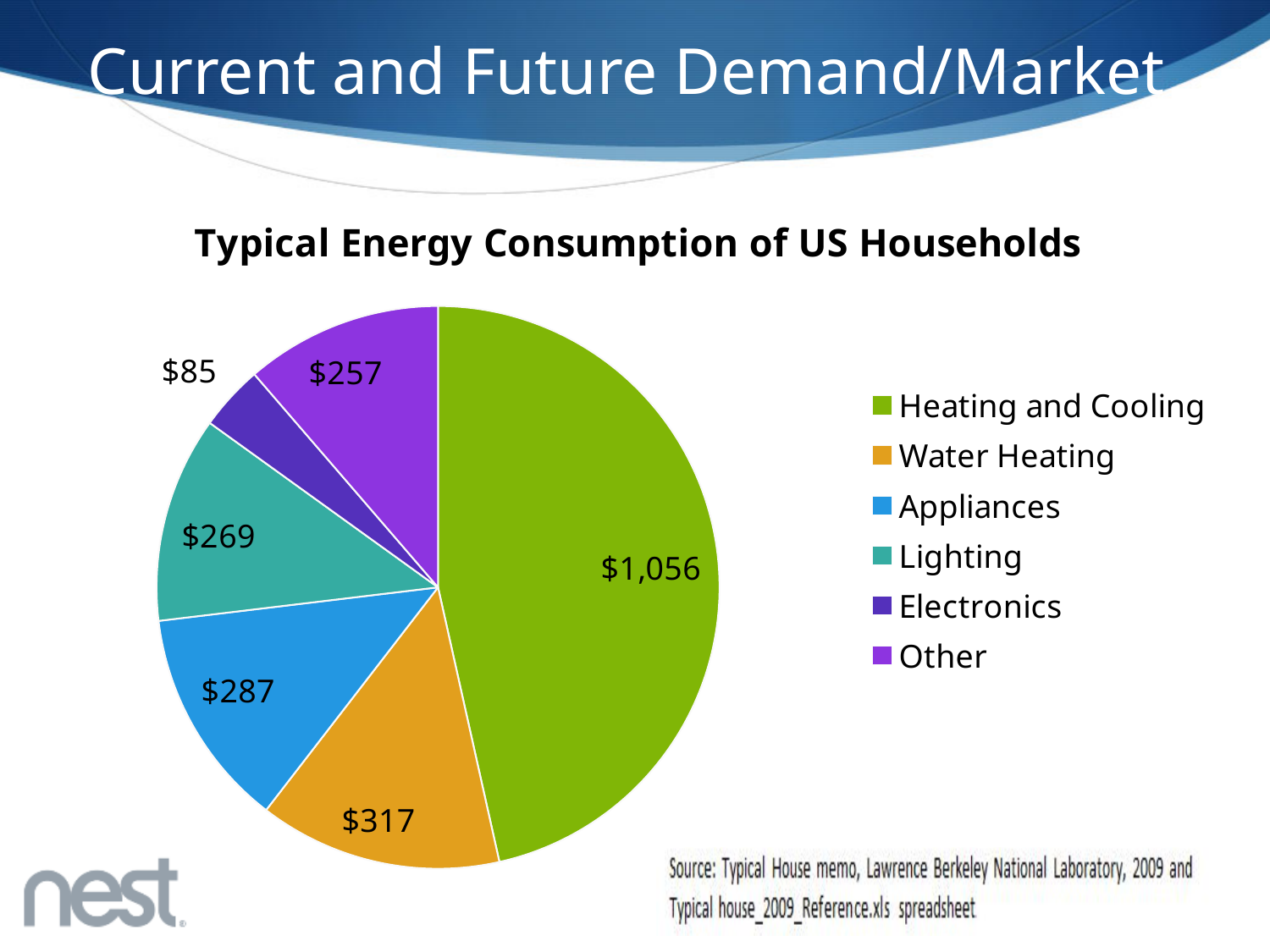
What is the value for Lighting? $269 What is the title of the chart? Typical Energy Consumption of US Households What kind of chart is shown on the slide? Pie chart What is the value for Heating and Cooling in the pie chart? $1,056 Which category has the smallest slice of the pie? Electronics What is the value for Water Heating? $317 Which category has the largest slice of the pie? Heating and Cooling Which is larger, Appliances or Other? Appliances How many categories does the pie chart show? 6 What is the value for Electronics? $85 What is the difference between Lighting and Electronics? $184 What is the difference between Heating and Cooling and Water Heating? $739